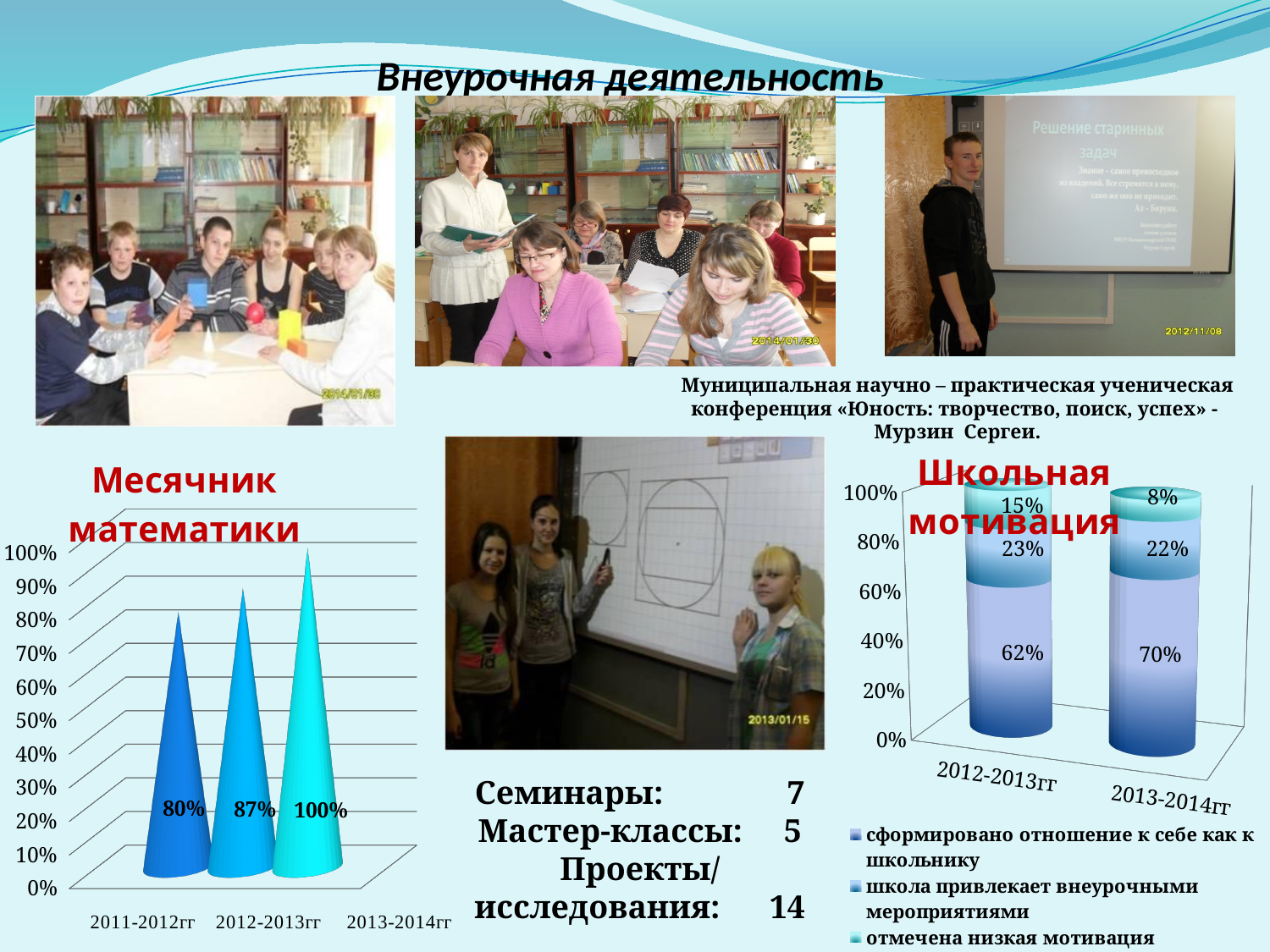
What kind of chart is 'Месячник математики'? bar chart How many categories are shown in the 'Месячник математики' chart? 3 In the 'Месячник математики' chart, which year has the highest value? 2013-2014гг In the 'Месячник математики' chart, what is the difference between the values for 2013-2014гг and 2011-2012гг? 20% In the 'Месячник математики' chart, do the values rise or fall from 2011-2012гг to 2013-2014гг? rise In the 'Месячник математики' chart, what is the value for 2011-2012гг? 80% How many series does the legend of the 'Школьная мотивация' chart list? 3 In the 'Месячник математики' chart, what is the value for 2012-2013гг? 87% In the 'Месячник математики' chart, which year has the lowest value? 2011-2012гг In the 'Школьная мотивация' chart, what is the value of the top segment for 2012-2013гг? 15% In the 'Школьная мотивация' chart, what is the value of the bottom segment for 2013-2014гг? 70% In the 'Школьная мотивация' chart, which year has the larger bottom segment, 2012-2013гг or 2013-2014гг? 2013-2014гг